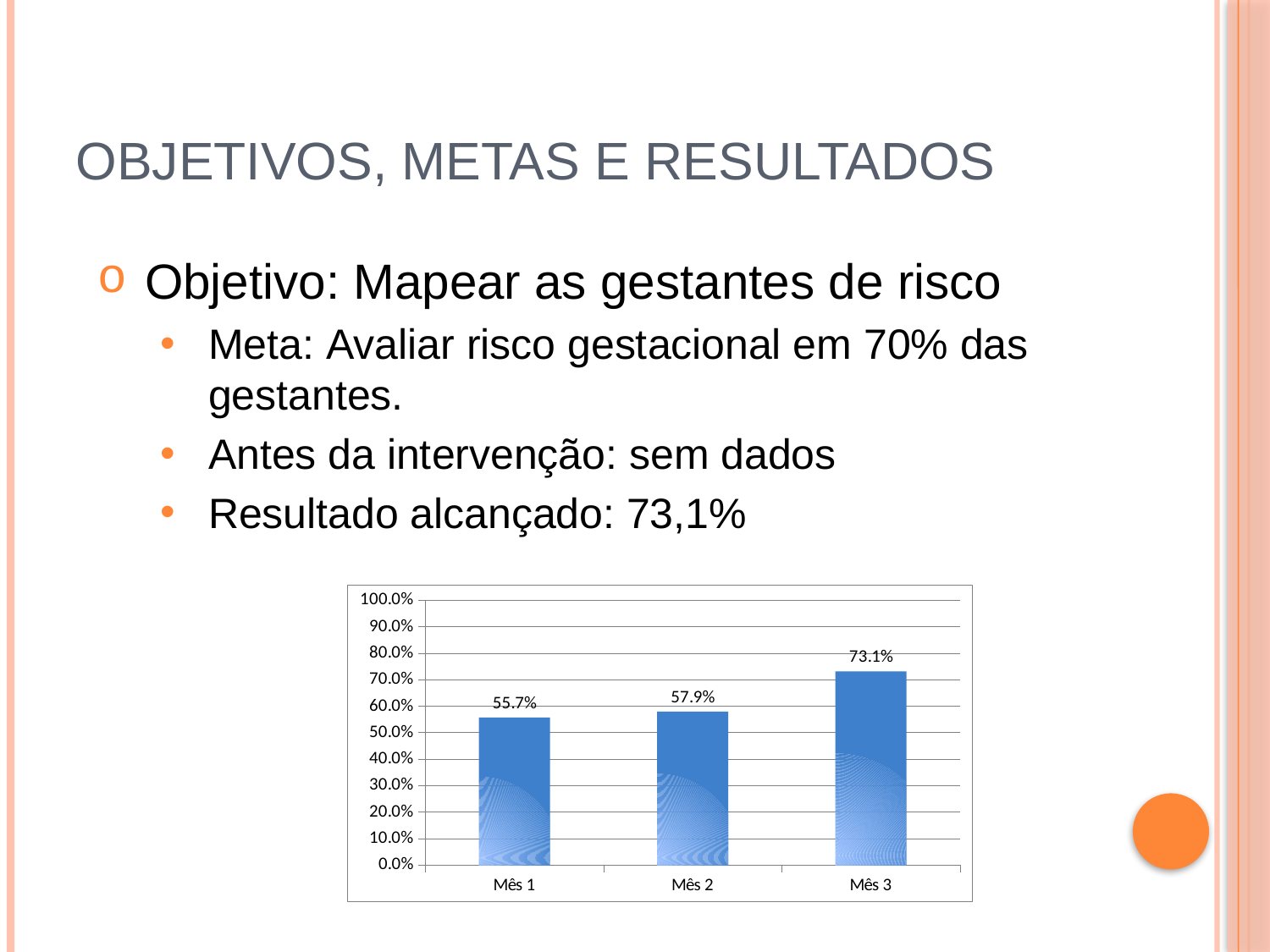
Which month has the highest value? Mês 3 Do the values rise or fall from Mês 1 to Mês 3? rise Which is larger, the value for Mês 3 or the value for Mês 2? Mês 3 What is the difference between the values for Mês 2 and Mês 1? 2.2% What kind of chart is shown on the slide? bar chart What is the value for Mês 2? 57.9% Which month has the lowest value? Mês 1 Is the value for Mês 3 greater or less than 70.0%? greater What is the value for Mês 3? 73.1% How many categories are shown on the x axis? 3 What is the difference between the values for Mês 3 and Mês 1? 17.4% What is the value for Mês 1? 55.7%